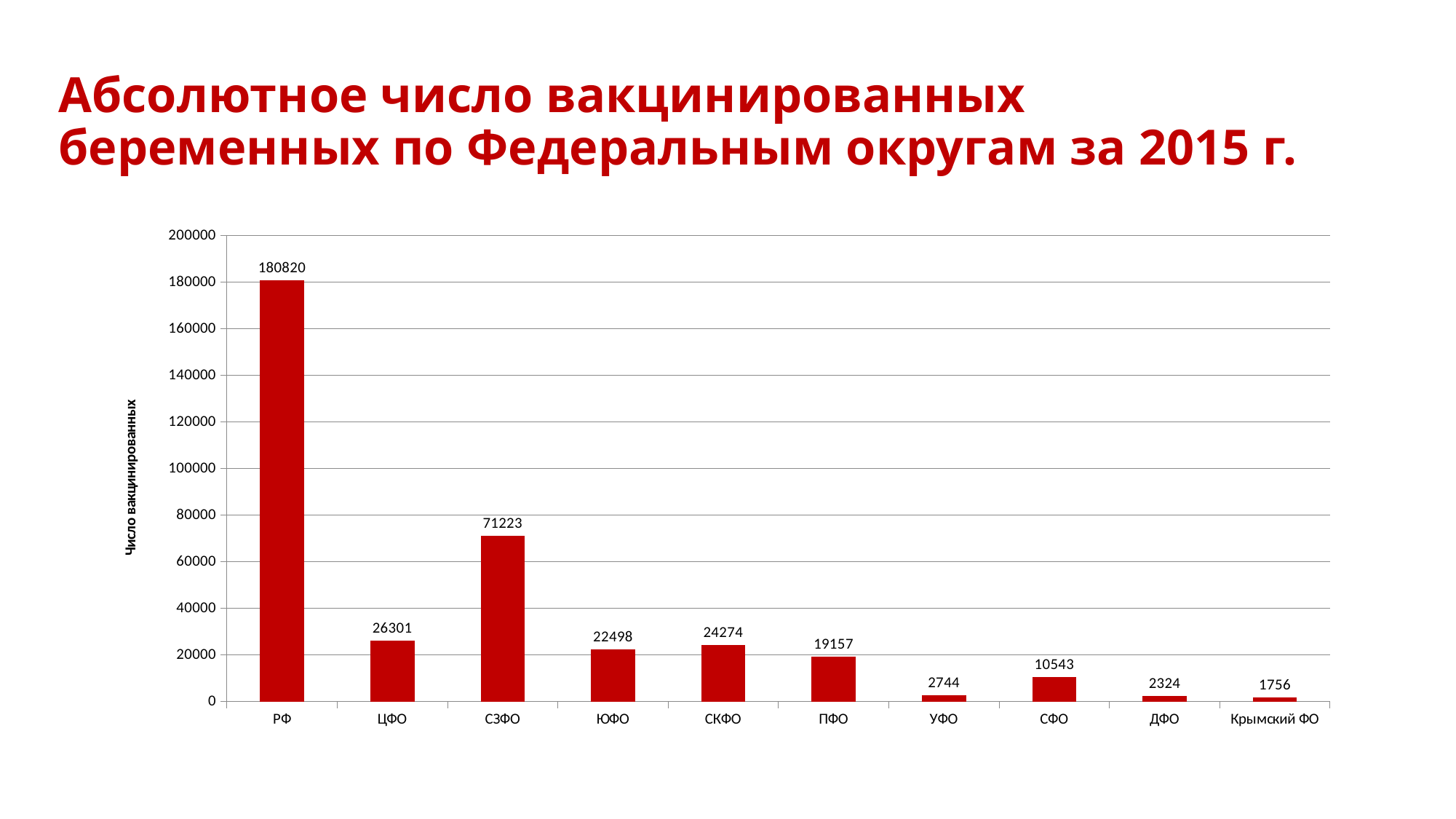
What is the difference between the values for СФО and УФО? 7799 Which is larger, the value for СКФО or the value for ЮФО? СКФО How many categories are shown on the x axis? 10 What is the value for СЗФО? 71223 Which category has the lowest value? Крымский ФО What is the value for Крымский ФО? 1756 What is the value for ПФО? 19157 Which category has the highest value? РФ Is the value for СЗФО greater or less than 60000? greater What is the difference between the values for ЦФО and ЮФО? 3803 What is the label of the vertical axis? Число вакцинированных What kind of chart is shown on the slide? bar chart